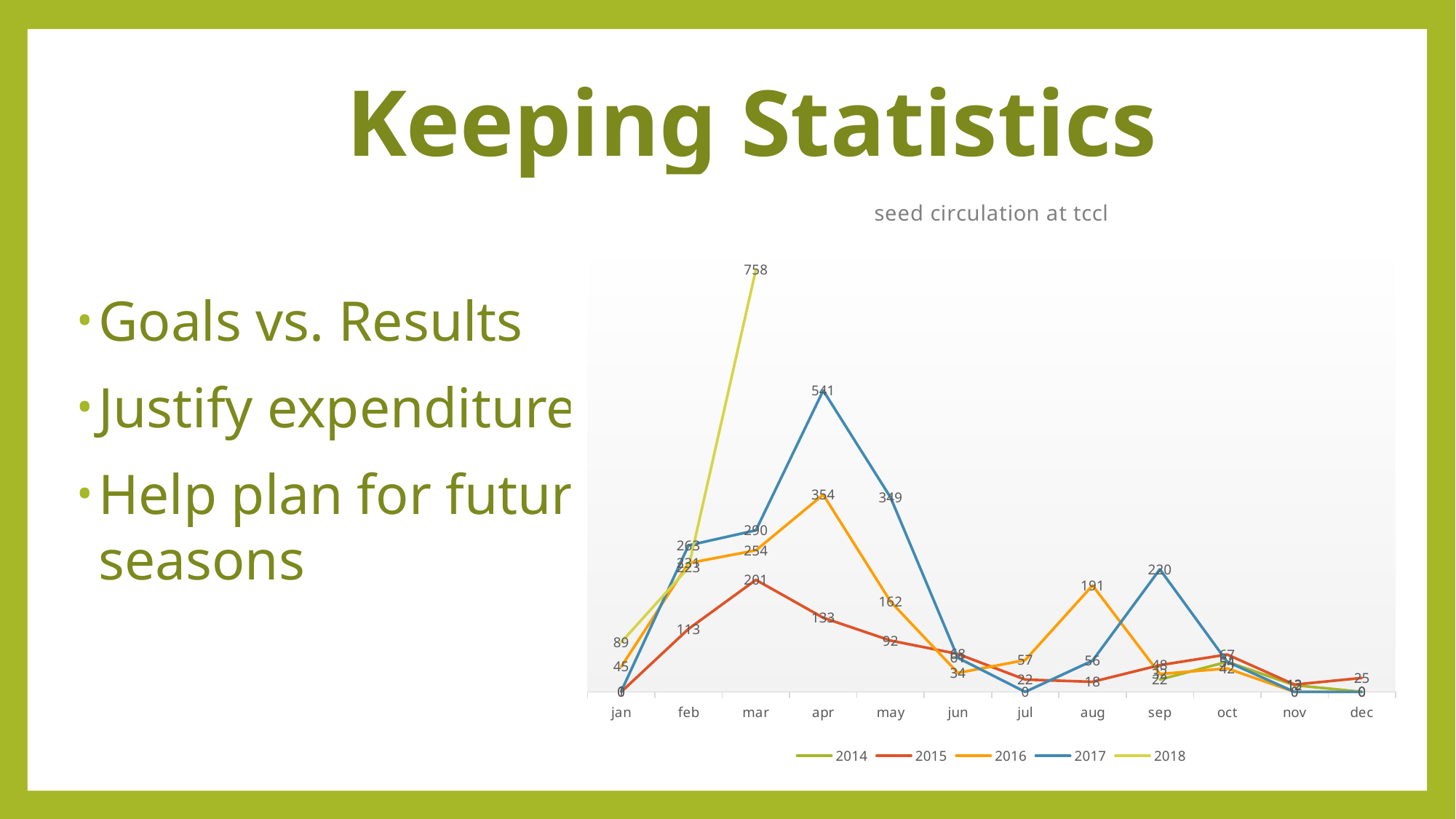
How many series does the legend list? 5 What is the value for 2018 in mar? 758 What is the value for 2017 in apr? 541 What is the value for 2015 in mar? 201 Which series and month has the highest value on the chart? 2018, mar What is the value for 2016 in apr? 354 Which is larger in apr, the 2017 value or the 2016 value? 2017 What is the difference between the 2017 and 2016 values in apr? 187 How many months are shown on the x axis? 12 What is the title of the chart? seed circulation at tccl What kind of chart is shown on the slide? line chart What is the value for 2016 in aug? 191